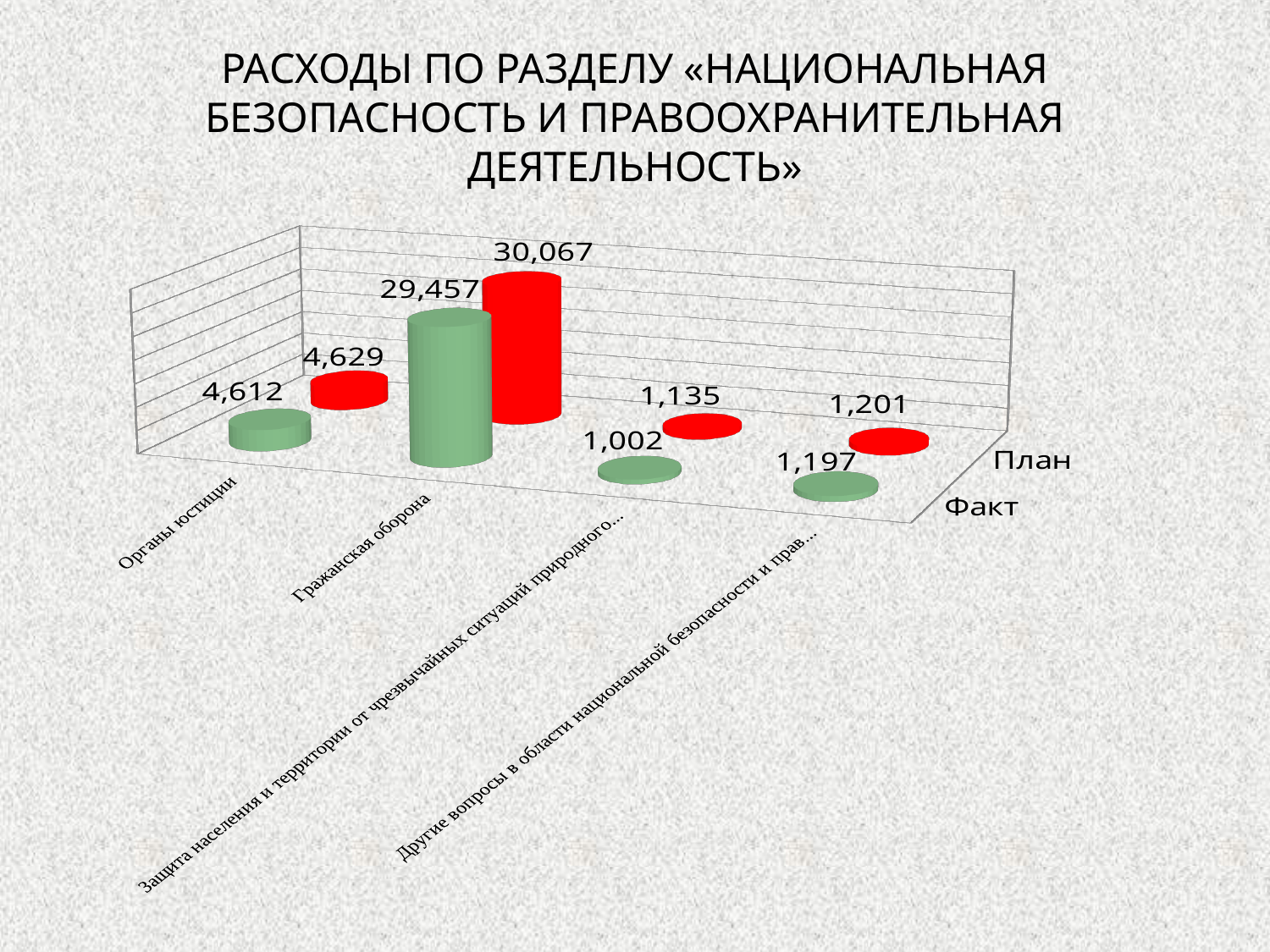
Which category has the lowest Факт value? Защита населения и территории от чрезвычайных ситуаций природного... What colour are the План bars? Red What is the Факт value for Гражданская оборона? 29,457 What is the План value for Гражданская оборона? 30,067 How many categories are shown on the chart? 4 What is the Факт value for Органы юстиции? 4,612 For Гражданская оборона, which is larger: the План value or the Факт value? План What is the Факт value for the category Другие вопросы в области национальной безопасности и прав...? 1,197 How many series does the chart show? 2 What is the План value for Органы юстиции? 4,629 Which category has the highest План value? Гражданская оборона What is the План value for the category Защита населения и территории от чрезвычайных ситуаций природного...? 1,135